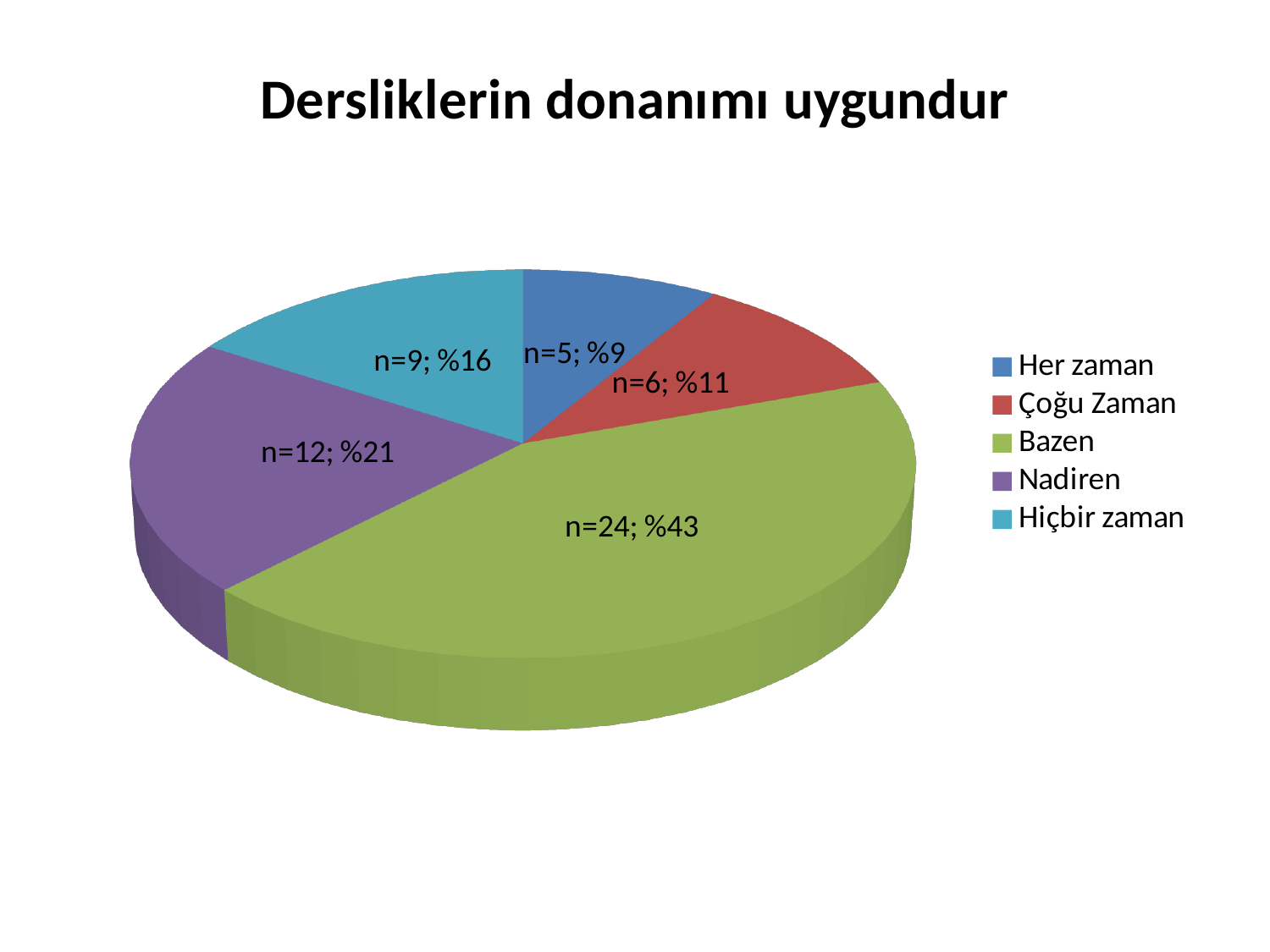
What is the count (n) for Nadiren? 12 Which is larger, the Çoğu Zaman slice or the Hiçbir zaman slice? Hiçbir zaman Which category has the smallest slice? Her zaman What percentage share does the Her zaman slice have? %9 What colour is the Nadiren slice? purple How many categories does the legend list? 5 What is the difference in count (n) between Bazen and Nadiren? 12 What is the title of the chart? Dersliklerin donanımı uygundur What percentage share does the Hiçbir zaman slice have? %16 Which category has the largest slice? Bazen What kind of chart is shown on the slide? pie chart What is the data label for the Bazen slice? n=24; %43